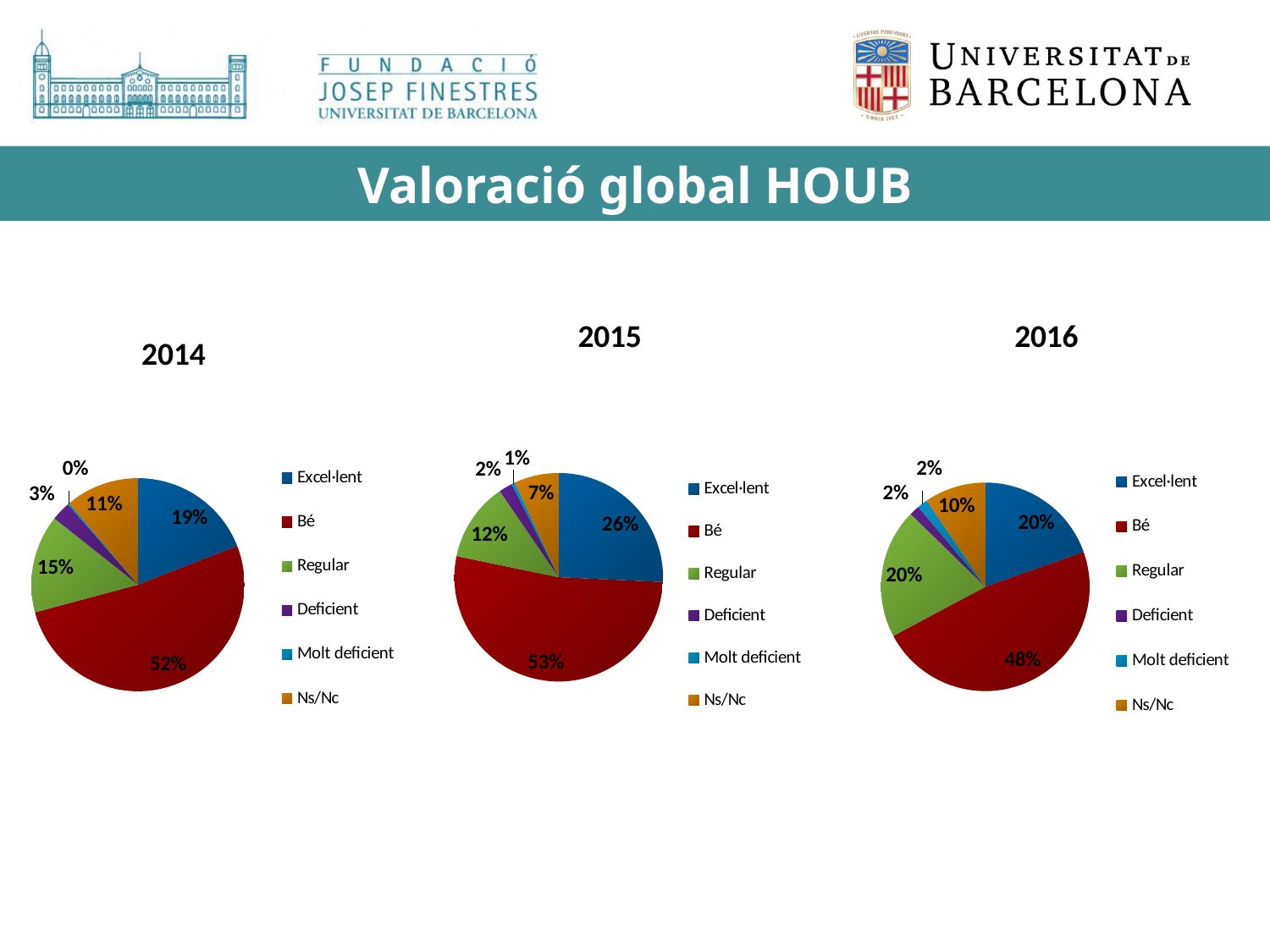
What is the title of the slide containing the three pie charts? Valoració global HOUB In the 2014 pie chart, which category has the smallest slice? Molt deficient Which is larger: the Regular share in the 2014 chart or the Regular share in the 2016 chart? 2016 In the 2016 pie chart, what share is labelled for Regular? 20% What is the difference between the Bé share in 2015 and the Bé share in 2016? 5% In the 2015 pie chart, what share is labelled for Excel·lent? 26% In the 2014 pie chart, what share is labelled for Bé? 52% How many categories does the legend of the 2016 pie chart list? 6 In the 2015 pie chart, which category has the largest slice? Bé What kind of chart is used for the 2014 data? Pie chart In the 2015 pie chart, what share is labelled for Ns/Nc? 7% In the 2014 pie chart, what share is labelled for Ns/Nc? 11%